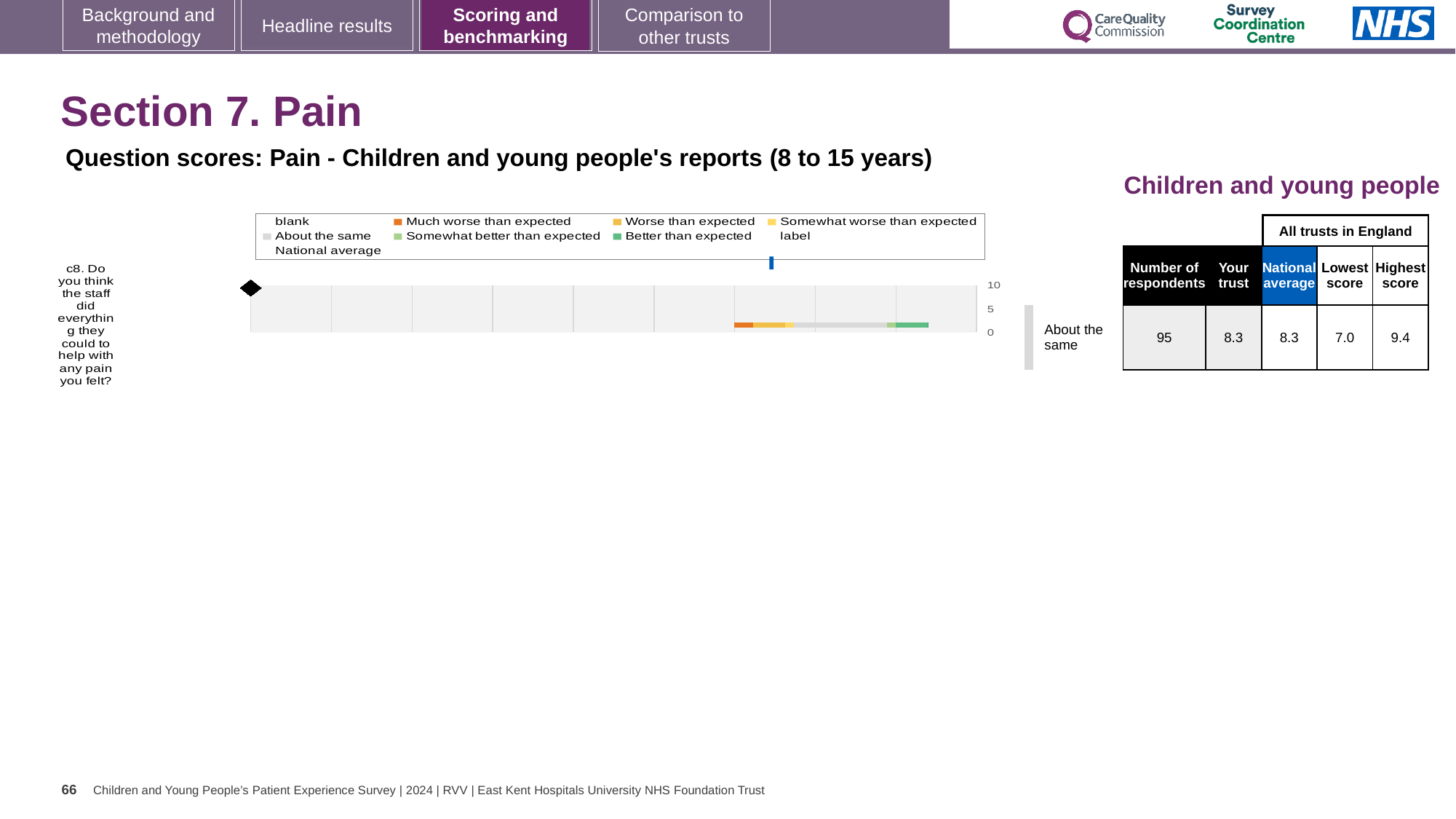
Which benchmark category is the trust's result for question c8 placed in? About the same What kind of chart is used to show the question score for c8? bar chart How many survey questions are plotted on the chart? 1 What is the difference between the highest and lowest trust scores for question c8? 2.4 What colour represents 'Much worse than expected' in the chart legend? orange What is the national average score for question c8? 8.3 Is the trust's score for question c8 higher than, lower than, or the same as the national average? the same How many respondents answered question c8? 95 What is the lowest score among all trusts in England for question c8? 7.0 Is the trust's score for question c8 greater or less than 5 on the chart axis? greater What is the 'Your trust' score for question c8 about staff helping with pain? 8.3 What is the highest score among all trusts in England for question c8? 9.4